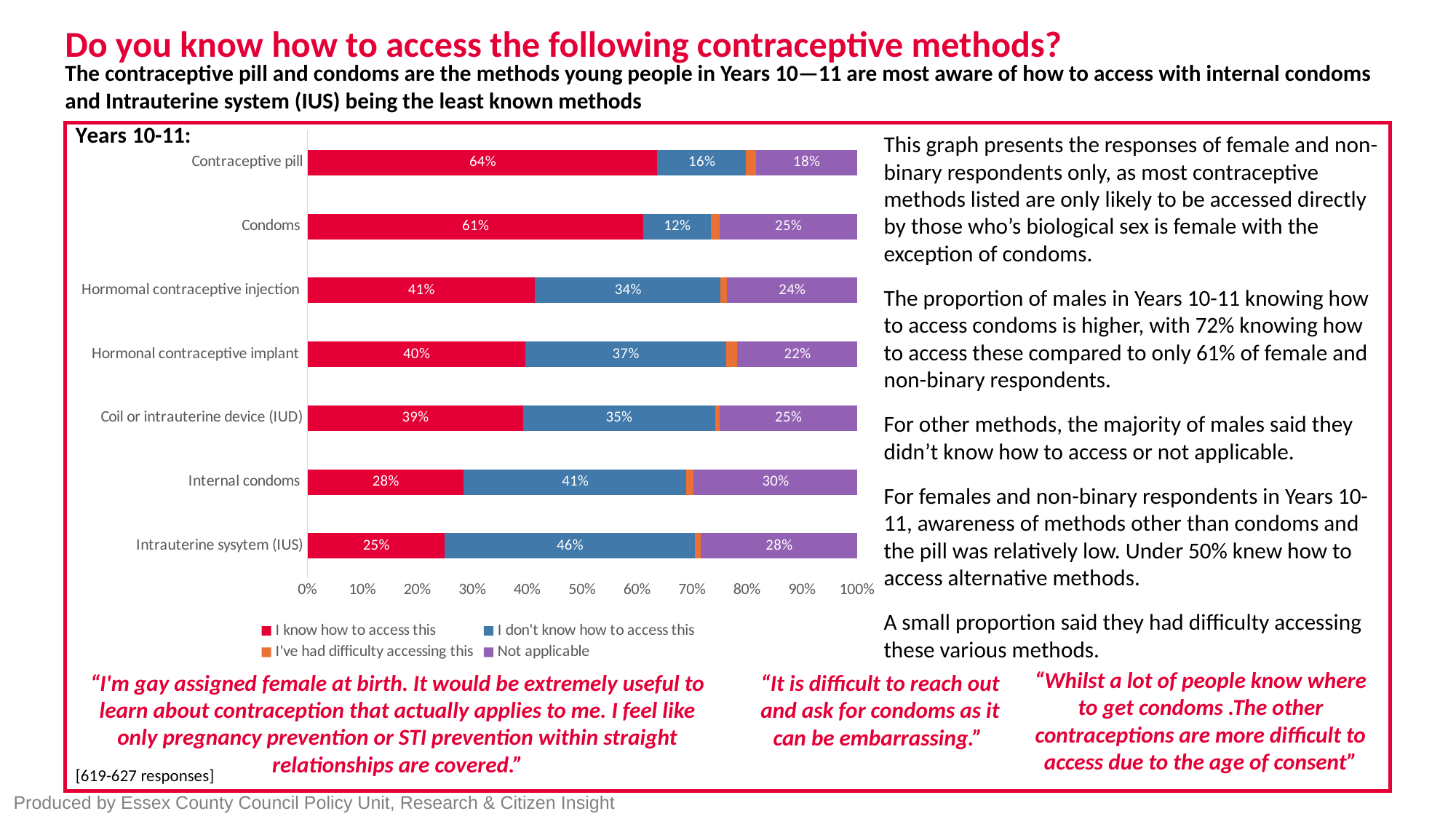
Which contraceptive method has the lowest percentage of respondents who know how to access it? Intrauterine sysytem (IUS) How many response categories does the legend list? 4 What percentage of respondents said they don't know how to access the Intrauterine system (IUS)? 46% What percentage of respondents said 'Not applicable' for condoms? 25% Which method has the highest 'I don't know how to access this' percentage? Intrauterine sysytem (IUS) Which has a larger 'Not applicable' share: Internal condoms or Intrauterine system (IUS)? Internal condoms For the hormonal contraceptive injection, how many percentage points higher is 'I know how to access this' than 'I don't know how to access this'? 7 percentage points How many contraceptive methods are listed on the chart? 7 What type of chart is shown on the slide? Stacked bar chart Which contraceptive method has the highest percentage of respondents who know how to access it? Contraceptive pill What is the difference in percentage points between those who know how to access the contraceptive pill and those who know how to access the IUS? 39 percentage points What percentage of Years 10-11 respondents said they know how to access the contraceptive pill? 64%